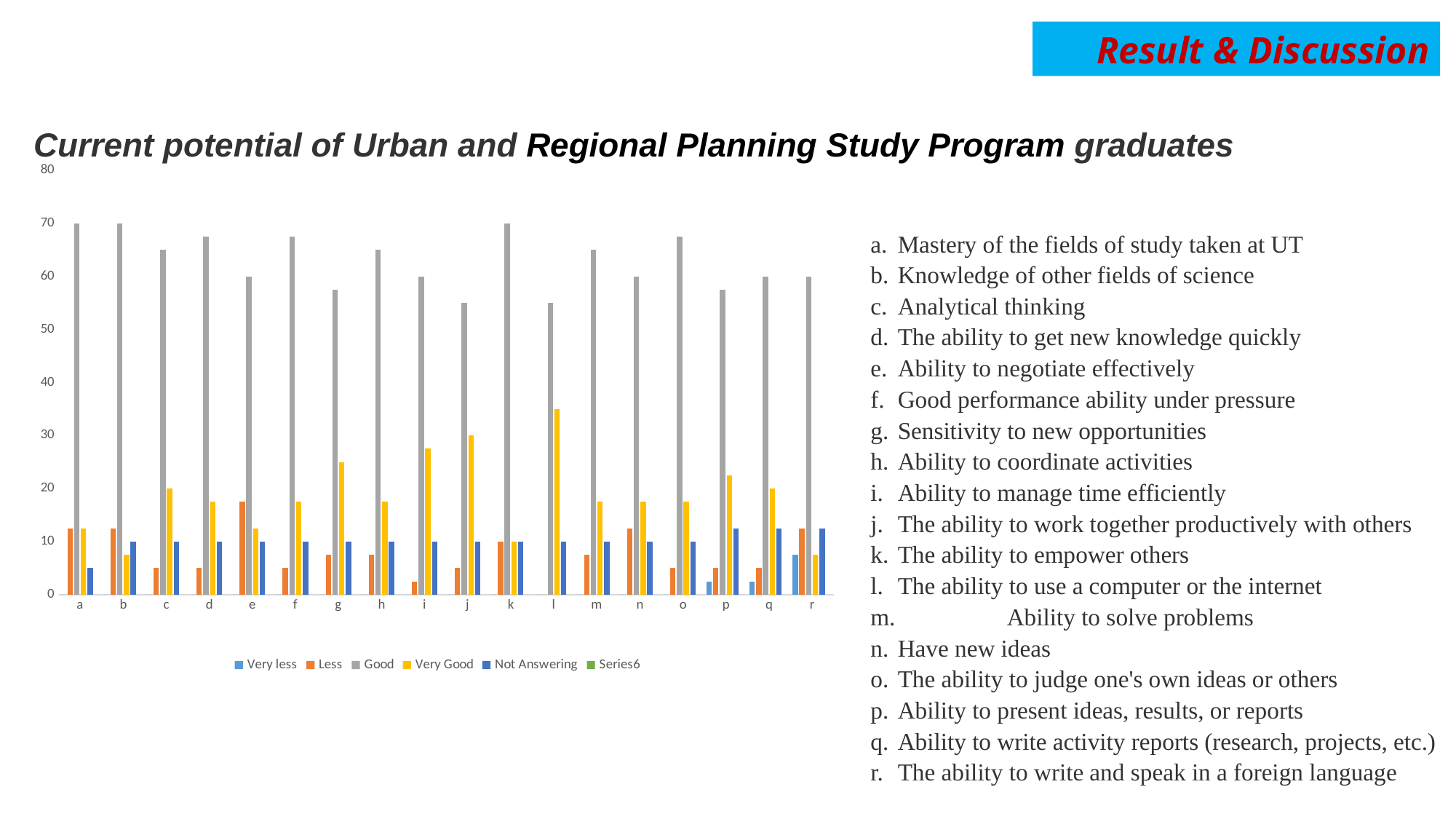
What kind of chart is shown on the slide? bar chart Which is larger, the Good value for category a or the Good value for category j? category a Is the Very less value for category r greater or less than 10? less Which category has the highest Very Good value? l Is the Very Good value for category g greater or less than 20? greater Is the Good value for category a greater or less than 60? greater How many series does the chart legend list? 6 How many categories are shown along the x axis of the chart? 18 Which series has the highest value for category a? Good What is the title of the chart? Current potential of Urban and Regional Planning Study Program graduates